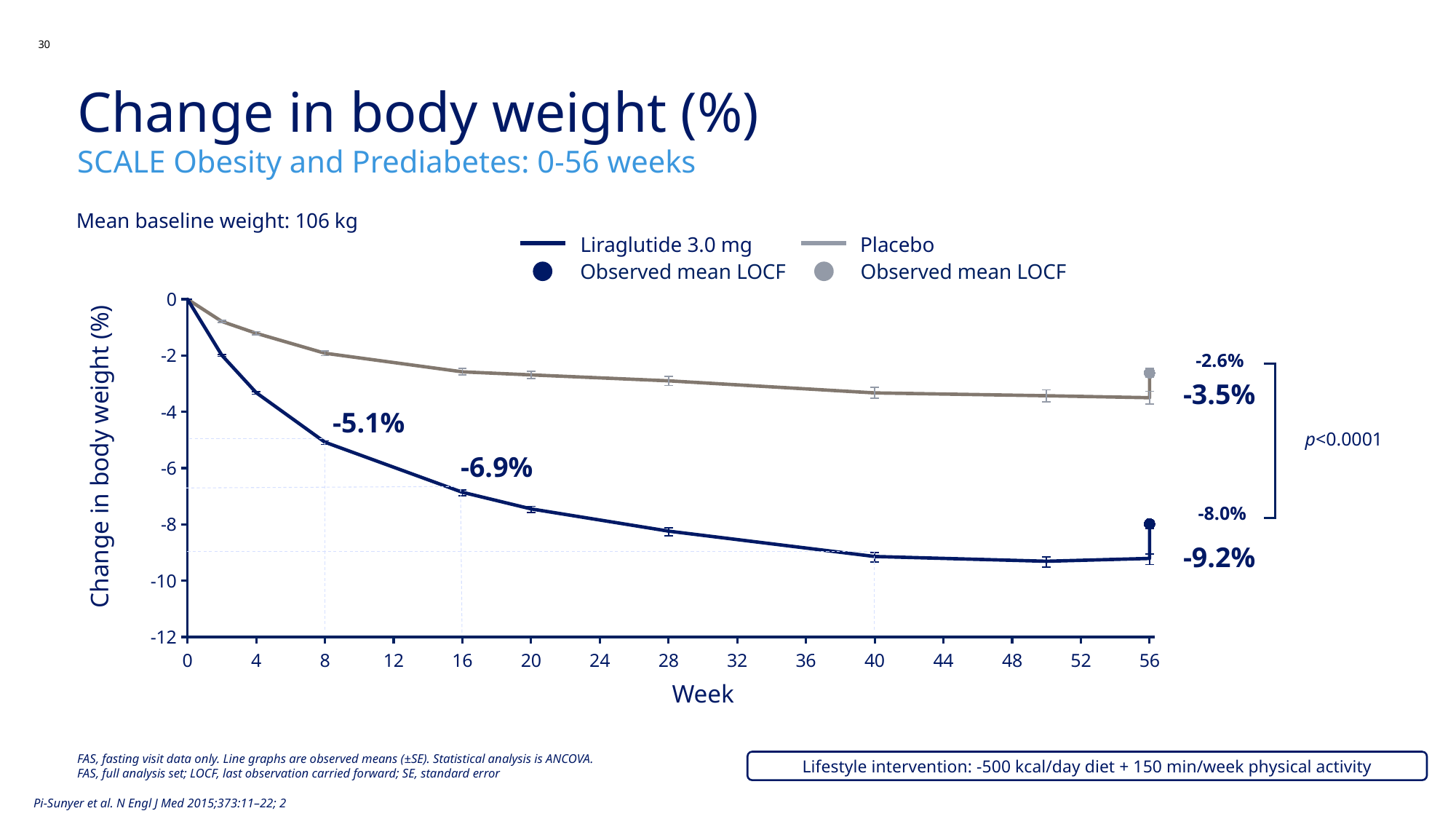
Does the Liraglutide 3.0 mg line rise or fall between week 0 and week 40? Fall What is the difference between the week 56 values for Liraglutide 3.0 mg (-9.2%) and Placebo (-3.5%)? 5.7 percentage points What is the labelled change in body weight for Liraglutide 3.0 mg at week 8? -5.1% What p-value is shown for the comparison between the two groups at week 56? p<0.0001 What is the labelled change in body weight for Liraglutide 3.0 mg at week 16? -6.9% What kind of chart is shown on the slide? Line chart What is the labelled change in body weight for Liraglutide 3.0 mg at week 56? -9.2% Is the value for Liraglutide 3.0 mg at week 40 greater or less than -8? less What is the observed mean LOCF value shown for Liraglutide 3.0 mg? -8.0% What is the observed mean LOCF value shown for Placebo? -2.6% What is the labelled change in body weight for Placebo at week 56? -3.5% Which series shows the greater reduction in body weight at week 56, Liraglutide 3.0 mg or Placebo? Liraglutide 3.0 mg